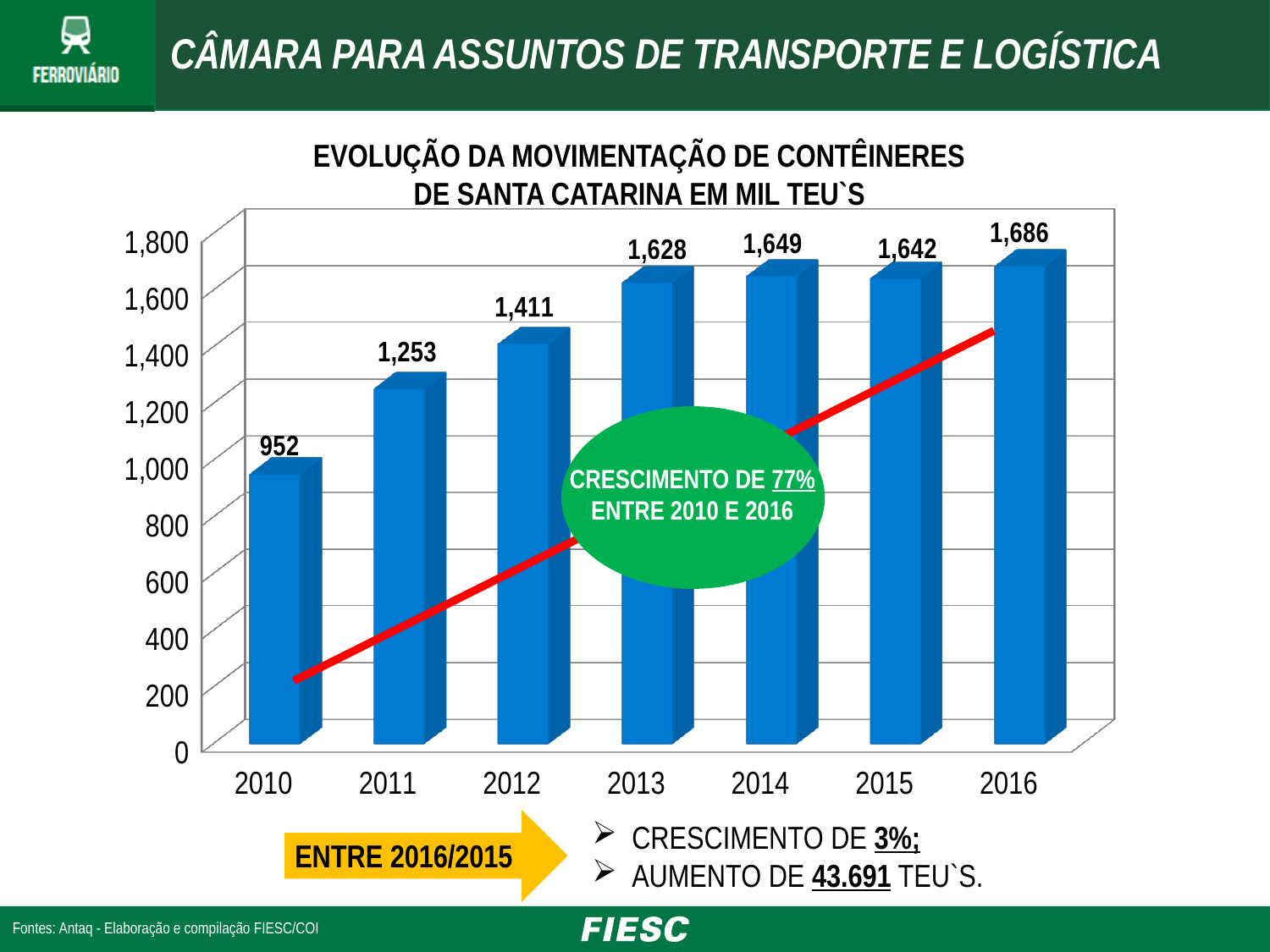
How many years are shown on the x axis? 7 Which is larger, the value for 2014 or the value for 2012? 2014 Do the values generally rise or fall from 2010 to 2016? rise What is the value for 2013? 1,628 What is the difference between the values for 2012 and 2011? 158 What is the value for 2016? 1,686 What is the difference between the values for 2016 and 2010? 734 Which year has the highest value? 2016 Is the value for 2011 greater or less than 1,200? greater What kind of chart is shown on the slide? bar chart Which year has the lowest value? 2010 What is the value for 2010? 952